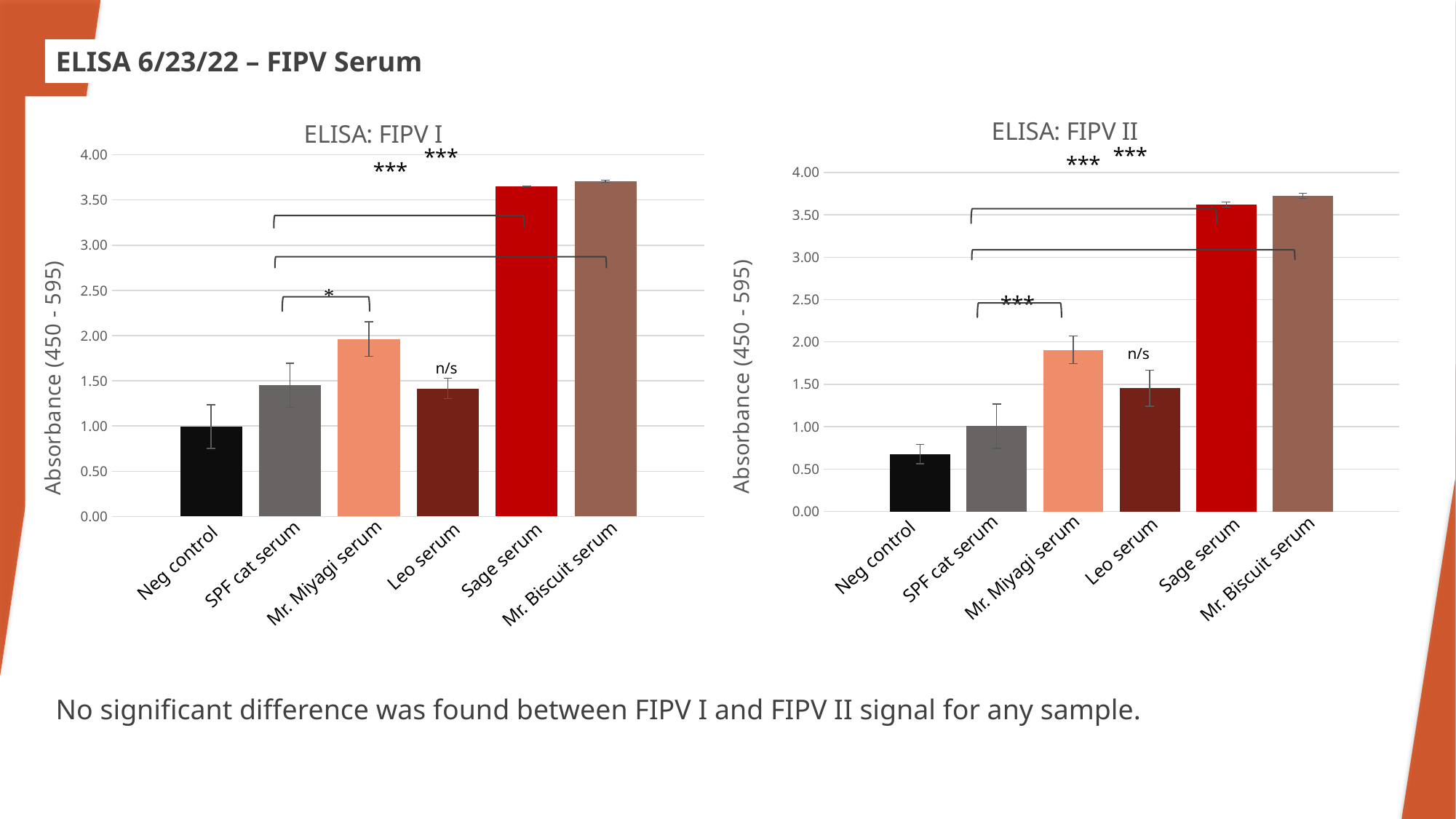
In the ELISA: FIPV II chart, is the value for Neg control greater or less than 1.00? less In the ELISA: FIPV I chart, is the value for Mr. Miyagi serum greater or less than 1.50? greater What kind of chart is the ELISA: FIPV I chart? bar chart How many categories are shown on the x axis of the ELISA: FIPV II chart? 6 In the ELISA: FIPV II chart, which category has the lowest absorbance? Neg control In the ELISA: FIPV II chart, is the value for Mr. Biscuit serum greater or less than 3.50? greater In the ELISA: FIPV II chart, which is larger, the value for Mr. Miyagi serum or the value for SPF cat serum? Mr. Miyagi serum In the ELISA: FIPV I chart, which is larger, the value for Mr. Miyagi serum or the value for Leo serum? Mr. Miyagi serum In the ELISA: FIPV I chart, which category has the lowest absorbance? Neg control What is the y-axis label of the ELISA: FIPV II chart? Absorbance (450 - 595)